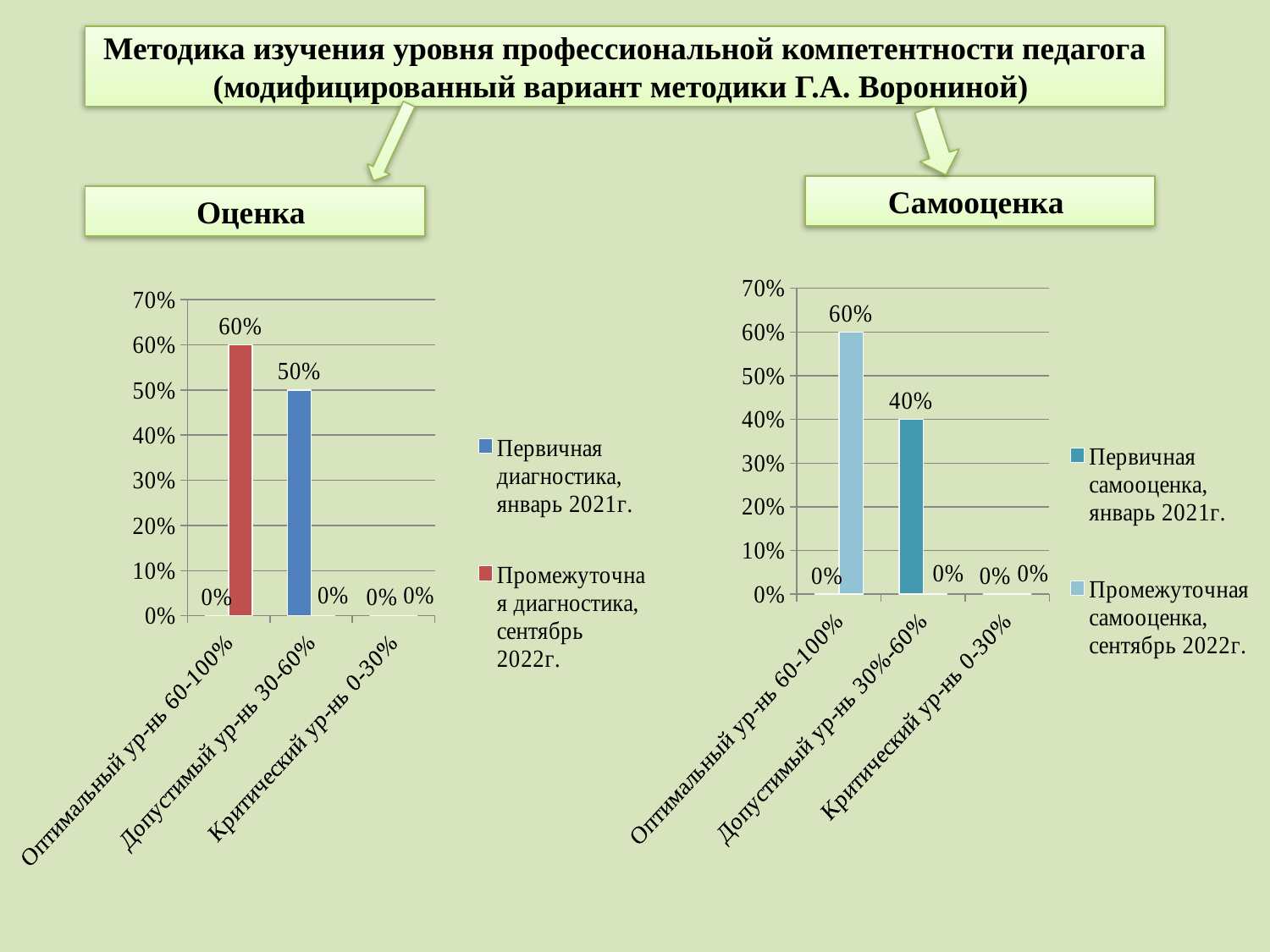
In the 'Самооценка' chart, what is the value of 'Первичная самооценка, январь 2021г.' for 'Допустимый ур-нь 30-60%'? 40% In the 'Самооценка' chart, what is the value of both series for 'Критический ур-нь 0-30%'? 0% In the 'Самооценка' chart, what is the difference between the 60% value for 'Оптимальный ур-нь 60-100%' and the 40% value for 'Допустимый ур-нь 30-60%'? 20% In the 'Оценка' chart, what is the value of 'Первичная диагностика, январь 2021г.' for 'Оптимальный ур-нь 60-100%'? 0% What type of chart is the 'Самооценка' chart? Bar chart How many series does the legend of the 'Оценка' chart list? 2 In the 'Самооценка' chart, what is the value of 'Промежуточная самооценка, сентябрь 2022г.' for 'Оптимальный ур-нь 60-100%'? 60% In the 'Оценка' chart, which category has the highest plotted value? Оптимальный ур-нь 60-100% How many categories are shown on the x axis of the 'Самооценка' chart? 3 In the 'Оценка' chart, what is the value of 'Промежуточная диагностика, сентябрь 2022г.' for 'Оптимальный ур-нь 60-100%'? 60% In the 'Оценка' chart, which is larger: the 'Промежуточная диагностика' value for 'Оптимальный ур-нь 60-100%' or the 'Первичная диагностика' value for 'Допустимый ур-нь 30-60%'? Промежуточная диагностика for Оптимальный ур-нь 60-100% In the 'Оценка' chart, what is the value of 'Первичная диагностика, январь 2021г.' for 'Допустимый ур-нь 30-60%'? 50%